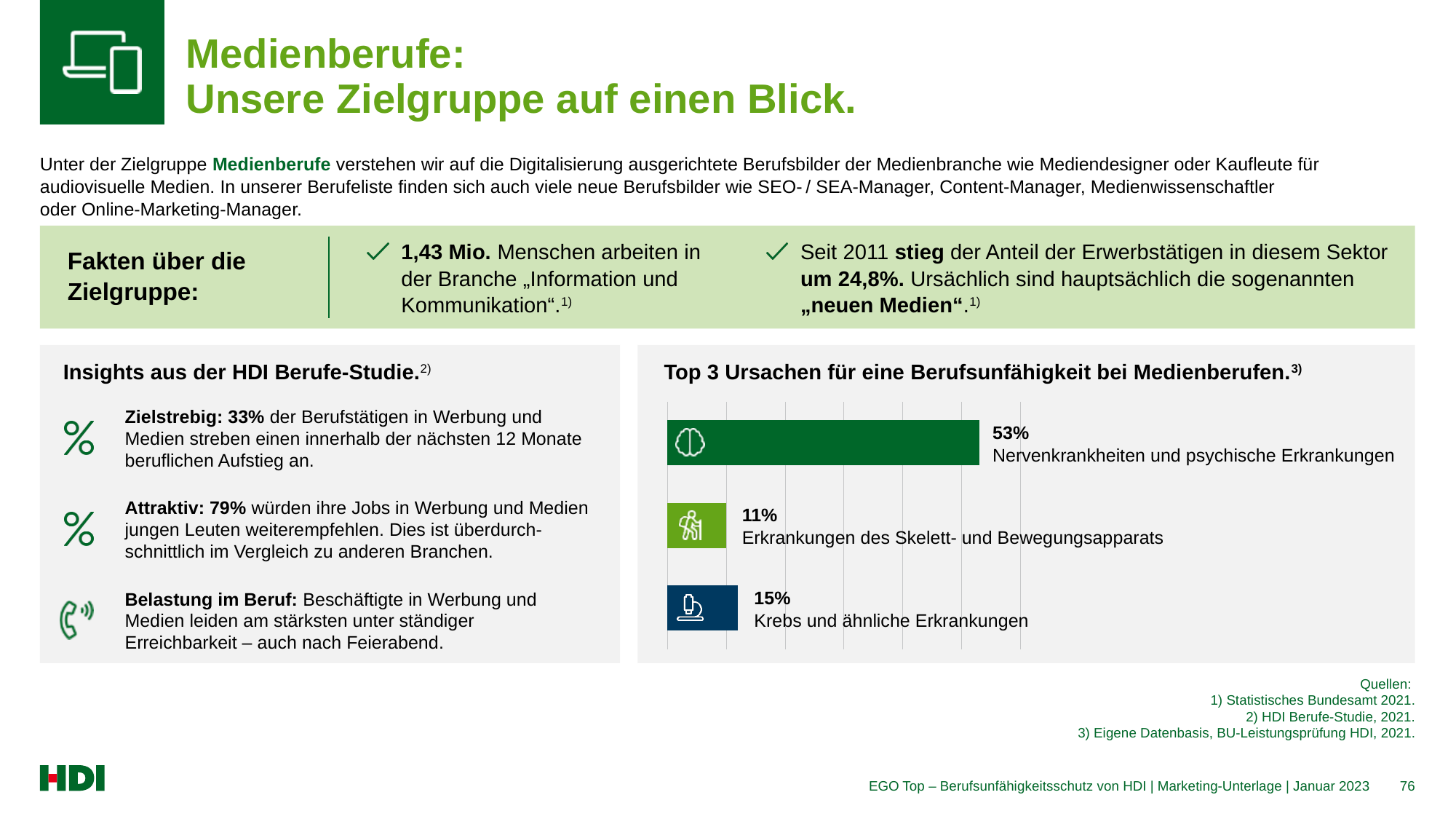
In the chart "Top 3 Ursachen für eine Berufsunfähigkeit bei Medienberufen", what is the value for Nervenkrankheiten und psychische Erkrankungen? 53% In the chart "Top 3 Ursachen für eine Berufsunfähigkeit bei Medienberufen", what is the difference between the values for Krebs und ähnliche Erkrankungen and Erkrankungen des Skelett- und Bewegungsapparats? 4% In the chart "Top 3 Ursachen für eine Berufsunfähigkeit bei Medienberufen", what is the difference between the values for Nervenkrankheiten und psychische Erkrankungen and Krebs und ähnliche Erkrankungen? 38% In the chart "Top 3 Ursachen für eine Berufsunfähigkeit bei Medienberufen", which cause has the lowest value? Erkrankungen des Skelett- und Bewegungsapparats In the chart "Top 3 Ursachen für eine Berufsunfähigkeit bei Medienberufen", what is the value for Erkrankungen des Skelett- und Bewegungsapparats? 11% In the chart "Top 3 Ursachen für eine Berufsunfähigkeit bei Medienberufen", which is larger: the value for Krebs und ähnliche Erkrankungen or for Erkrankungen des Skelett- und Bewegungsapparats? Krebs und ähnliche Erkrankungen In the chart "Top 3 Ursachen für eine Berufsunfähigkeit bei Medienberufen", what is the total of the three values shown? 79% In the chart "Top 3 Ursachen für eine Berufsunfähigkeit bei Medienberufen", what is the value for Krebs und ähnliche Erkrankungen? 15% What type of chart is shown under "Top 3 Ursachen für eine Berufsunfähigkeit bei Medienberufen"? bar chart What is the title of the bar chart on the right side of the slide? Top 3 Ursachen für eine Berufsunfähigkeit bei Medienberufen. In the chart "Top 3 Ursachen für eine Berufsunfähigkeit bei Medienberufen", which cause has the highest value? Nervenkrankheiten und psychische Erkrankungen How many causes are shown in the chart "Top 3 Ursachen für eine Berufsunfähigkeit bei Medienberufen"? 3